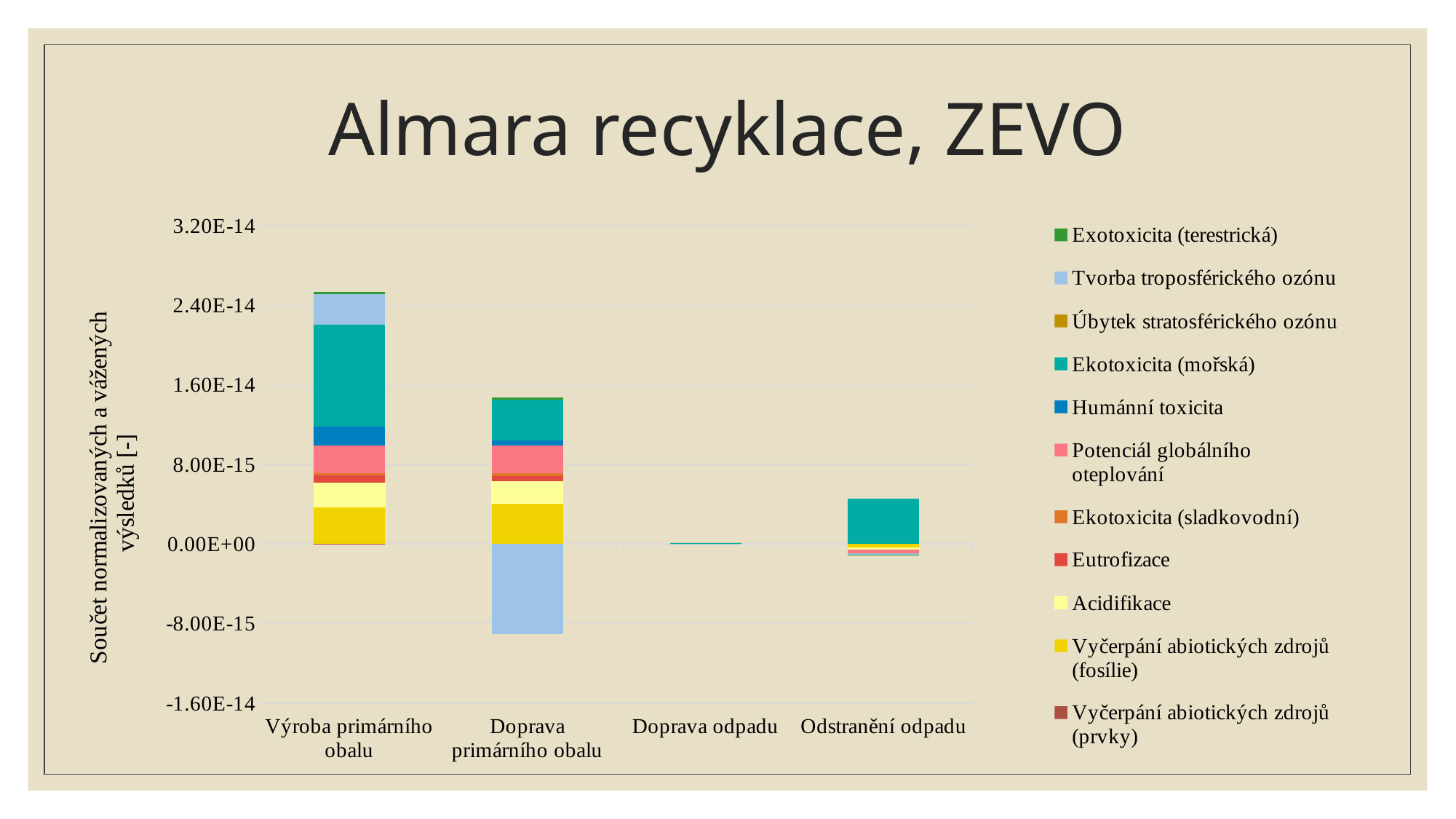
How many series does the chart's legend list? 11 Which category has the tallest positive stacked bar? Výroba primárního obalu How many categories are shown on the x axis of the chart? 4 What kind of chart is shown on the slide? Stacked bar chart Is the top of the positive stack for Doprava primárního obalu greater or less than 1.60E-14? less Is the top of the positive stack for Výroba primárního obalu greater or less than 1.60E-14? greater Which has the larger positive stacked bar, Výroba primárního obalu or Odstranění odpadu? Výroba primárního obalu Which category has the smallest stacked bar overall? Doprava odpadu Is the top of the positive stack for Odstranění odpadu greater or less than 8.00E-15? less What is the title of the chart? Almara recyklace, ZEVO Which category has a large negative (below zero) segment for Tvorba troposférického ozónu? Doprava primárního obalu What is the label of the vertical axis? Součet normalizovaných a vážených výsledků [-]